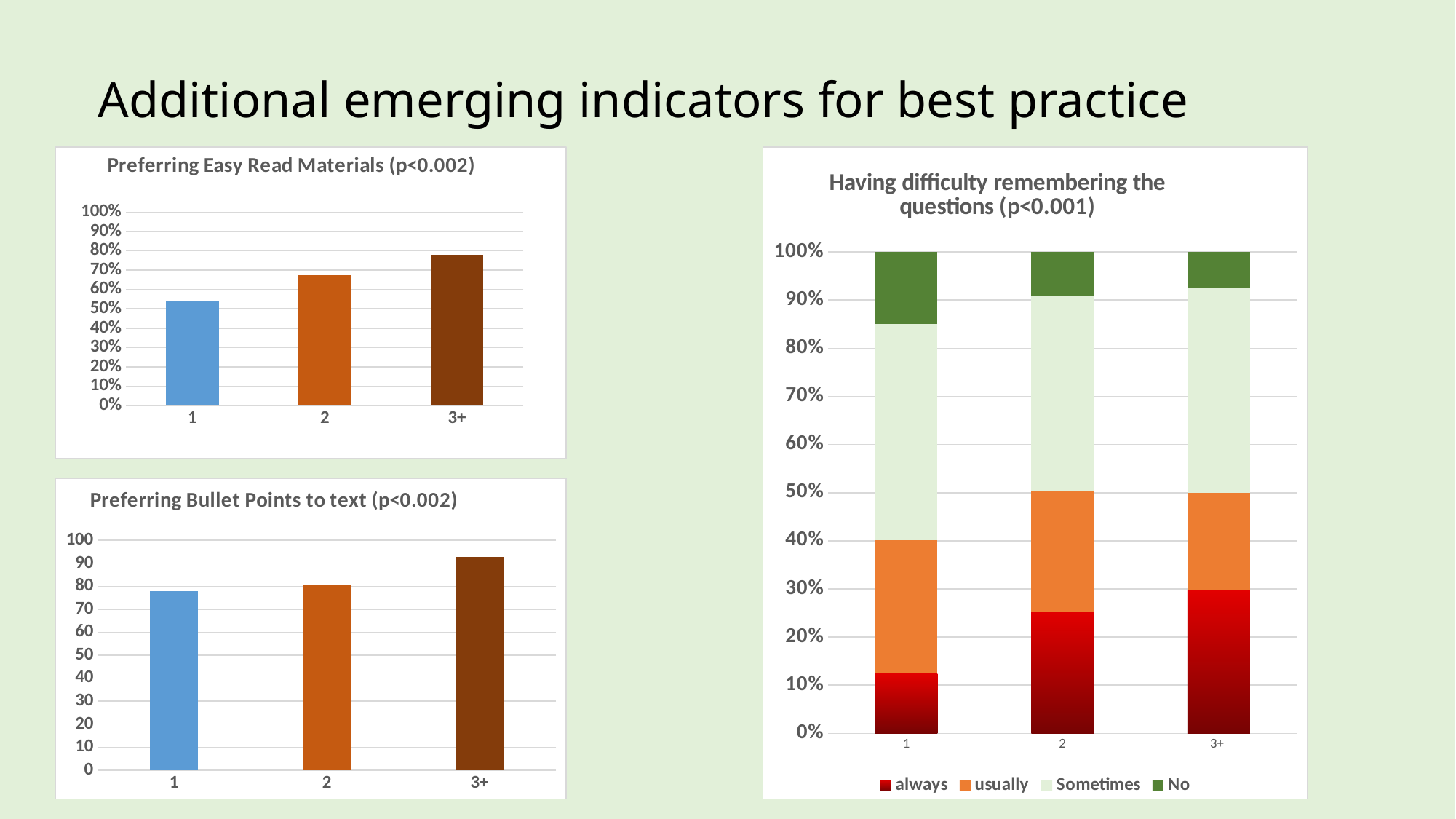
In the 'Preferring Bullet Points to text' chart, is the value for category 3+ greater or less than 90? greater In the 'Having difficulty remembering the questions' chart, which category has the largest 'always' segment? 3+ How many categories are shown on the x axis of the 'Preferring Bullet Points to text' chart? 3 In the 'Preferring Easy Read Materials' chart, do the values rise or fall from category 1 to 3+? rise In the 'Preferring Bullet Points to text' chart, is the value for category 1 greater or less than 80? less What kind of chart is the 'Having difficulty remembering the questions' chart? stacked bar chart In the 'Preferring Easy Read Materials' chart, which category has the lowest bar? 1 In the 'Preferring Easy Read Materials' chart, is the value for category 1 greater or less than 60%? less How many series does the legend list in the 'Having difficulty remembering the questions' chart? 4 In the 'Preferring Easy Read Materials' chart, which category has the highest bar? 3+ In the 'Preferring Bullet Points to text' chart, which category has the highest bar? 3+